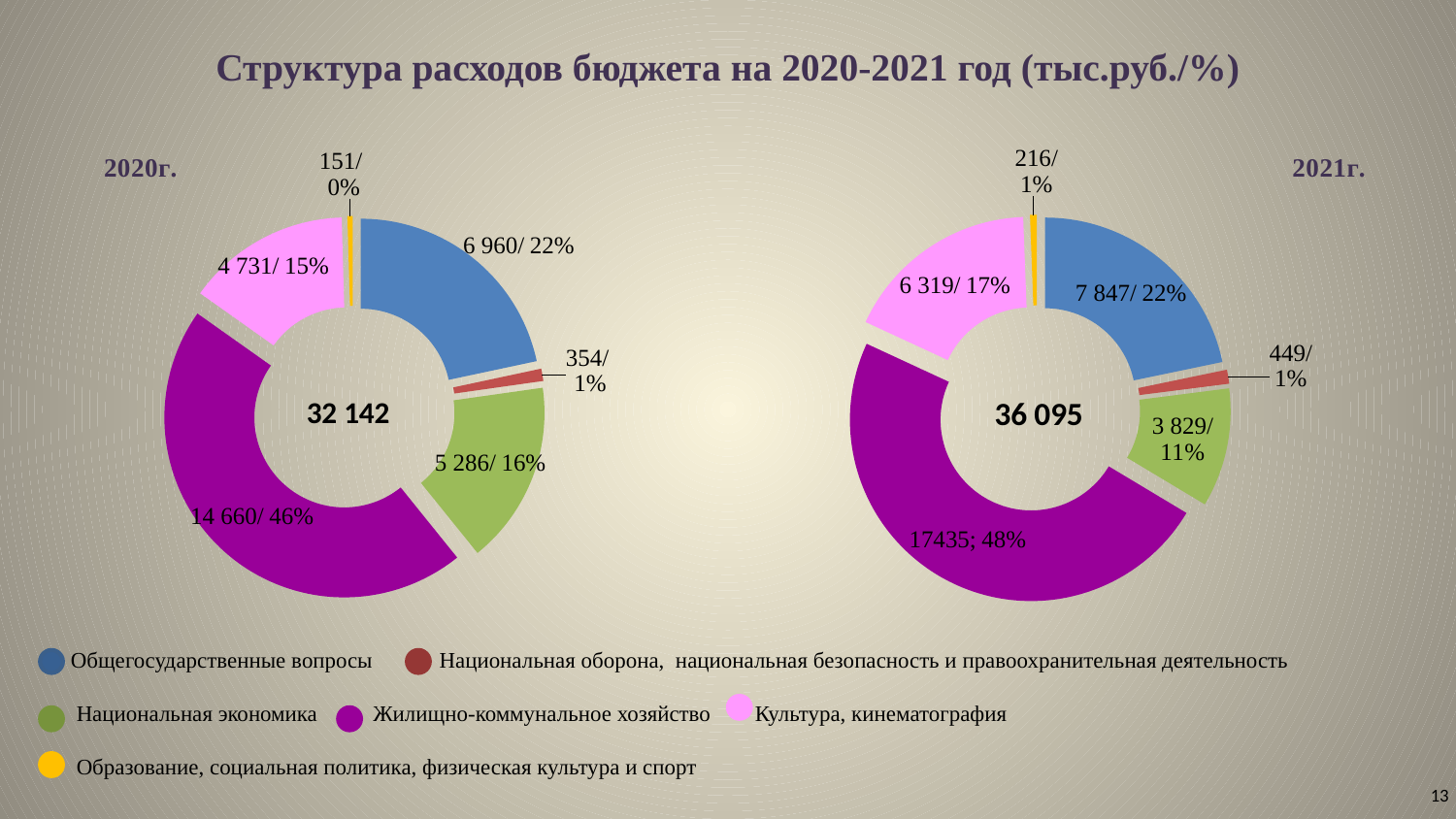
How many categories does the legend list? 6 In the 2020г. chart, what is the value for Жилищно-коммунальное хозяйство? 14 660/ 46% What total is shown in the centre of the 2020г. chart? 32 142 What type of chart is used for the 2020 and 2021 budget structure on this slide? Pie (donut) chart What is the difference between the Жилищно-коммунальное хозяйство value in 2021г. (17435) and in 2020г. (14 660)? 2775 In the 2020г. chart, what is the value for Культура, кинематография? 4 731/ 15% Which is larger: Национальная экономика in 2020г. or in 2021г.? 2020г. (5 286) In the 2020г. chart, which category has the largest share? Жилищно-коммунальное хозяйство What total is shown in the centre of the 2021г. chart? 36 095 In the 2021г. chart, what is the value for Общегосударственные вопросы? 7 847/ 22% In the 2021г. chart, what is the value for Национальная экономика? 3 829/ 11% In the 2021г. chart, which category has the smallest value? Образование, социальная политика, физическая культура и спорт